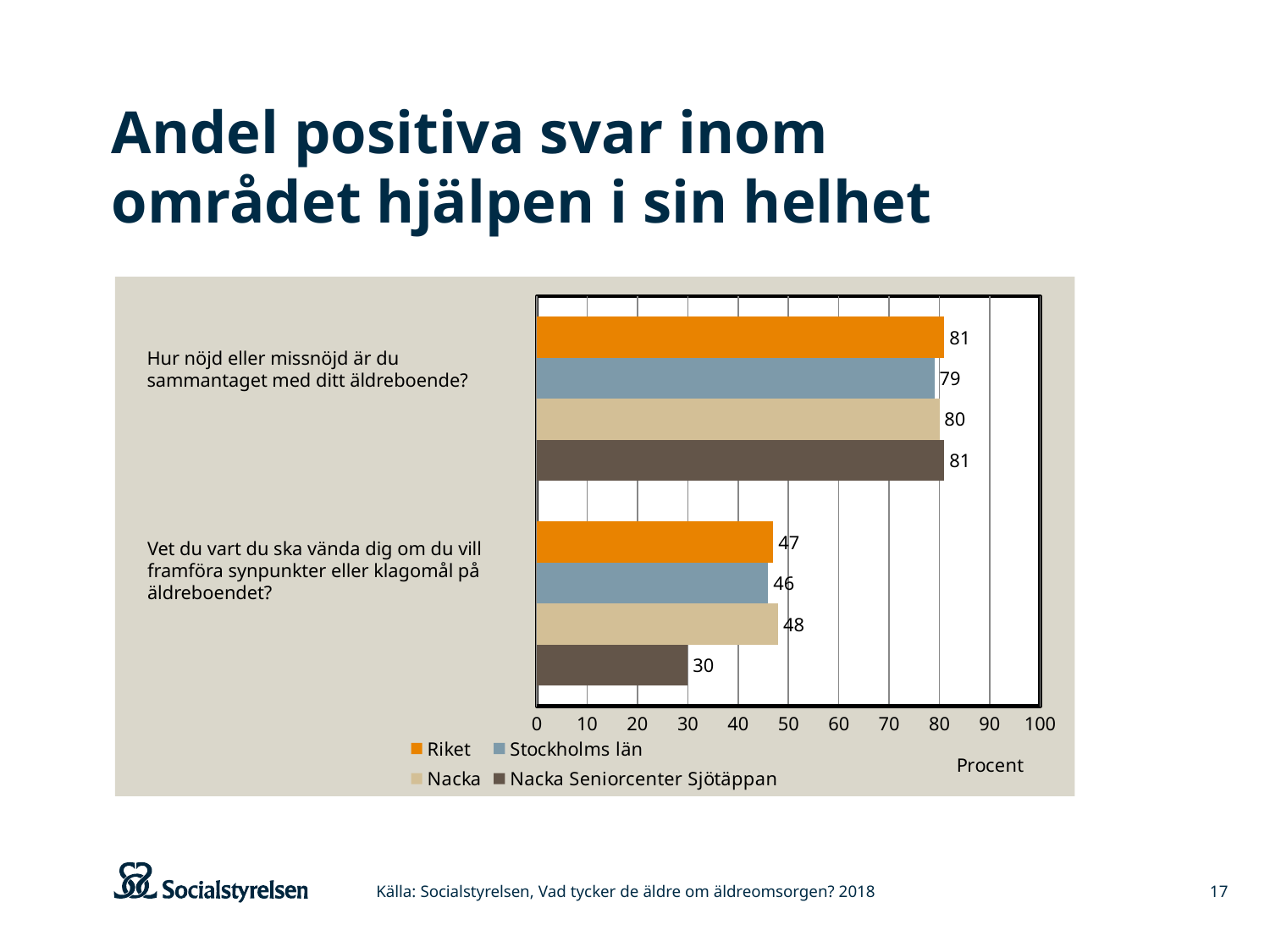
What kind of chart is shown on the slide? Bar chart What is the difference between the Nacka value and the Nacka Seniorcenter Sjötäppan value on the question "Vet du vart du ska vända dig om du vill framföra synpunkter eller klagomål på äldreboendet?"? 18 How many series does the legend list? 4 How many questions (categories) are shown on the chart? 2 Which series has the lowest value on the question "Vet du vart du ska vända dig om du vill framföra synpunkter eller klagomål på äldreboendet?"? Nacka Seniorcenter Sjötäppan Which series has the highest value on the question "Vet du vart du ska vända dig om du vill framföra synpunkter eller klagomål på äldreboendet?"? Nacka Which is larger on the question "Hur nöjd eller missnöjd är du sammantaget med ditt äldreboende?": the value for Riket or the value for Stockholms län? Riket What is the label on the horizontal axis of the chart? Procent What is the value for Stockholms län on the question "Hur nöjd eller missnöjd är du sammantaget med ditt äldreboende?"? 79 What is the value for Riket on the question "Hur nöjd eller missnöjd är du sammantaget med ditt äldreboende?"? 81 What is the value for Nacka Seniorcenter Sjötäppan on the question "Vet du vart du ska vända dig om du vill framföra synpunkter eller klagomål på äldreboendet?"? 30 What is the value for Nacka on the question "Vet du vart du ska vända dig om du vill framföra synpunkter eller klagomål på äldreboendet?"? 48